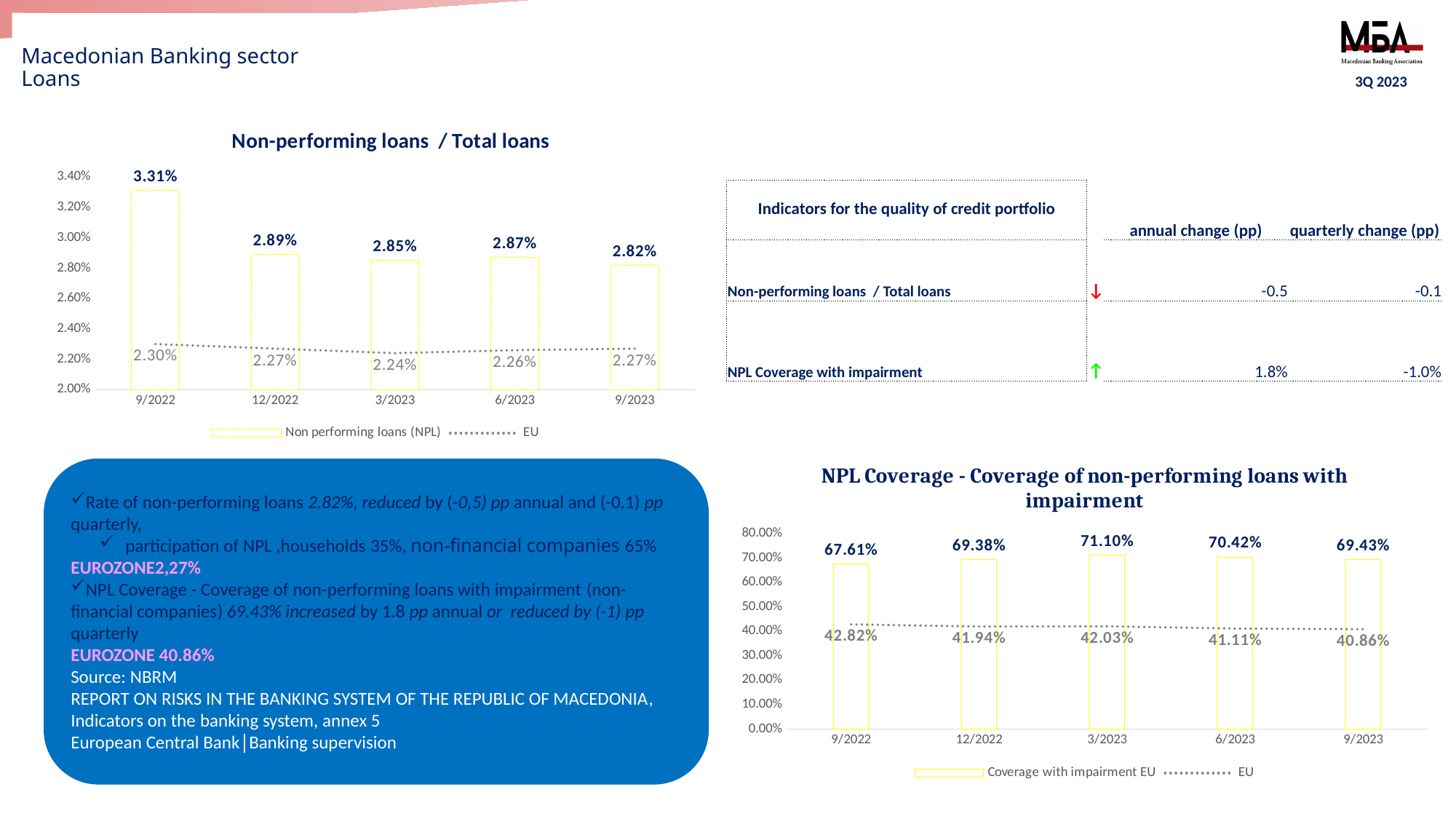
What type of chart is the 'NPL Coverage - Coverage of non-performing loans with impairment' chart? Bar chart with a dotted line In the 'Non-performing loans / Total loans' chart, what is the NPL value for 9/2022? 3.31% In the 'Non-performing loans / Total loans' chart, what is the difference between the NPL value for 9/2022 and the NPL value for 9/2023? 0.49 percentage points In the 'NPL Coverage - Coverage of non-performing loans with impairment' chart, what is the coverage value for 3/2023? 71.10% In the 'NPL Coverage - Coverage of non-performing loans with impairment' chart, which period has the lowest coverage value? 9/2022 In the 'Non-performing loans / Total loans' chart, which period has the highest NPL value? 9/2022 In the 'Non-performing loans / Total loans' chart, what is the EU value for 3/2023? 2.24% In the 'NPL Coverage - Coverage of non-performing loans with impairment' chart, what is the EU value for 9/2023? 40.86% In the 'NPL Coverage - Coverage of non-performing loans with impairment' chart, what is the difference between the coverage value and the EU value for 9/2023? 28.57 percentage points In the 'NPL Coverage - Coverage of non-performing loans with impairment' chart, is the coverage value for 12/2022 larger than the EU value for 12/2022? Yes, 69.38% is larger than 41.94% In the 'Non-performing loans / Total loans' chart, how many periods are shown on the x axis? 5 In the 'Non-performing loans / Total loans' chart, how many series does the legend list? 2